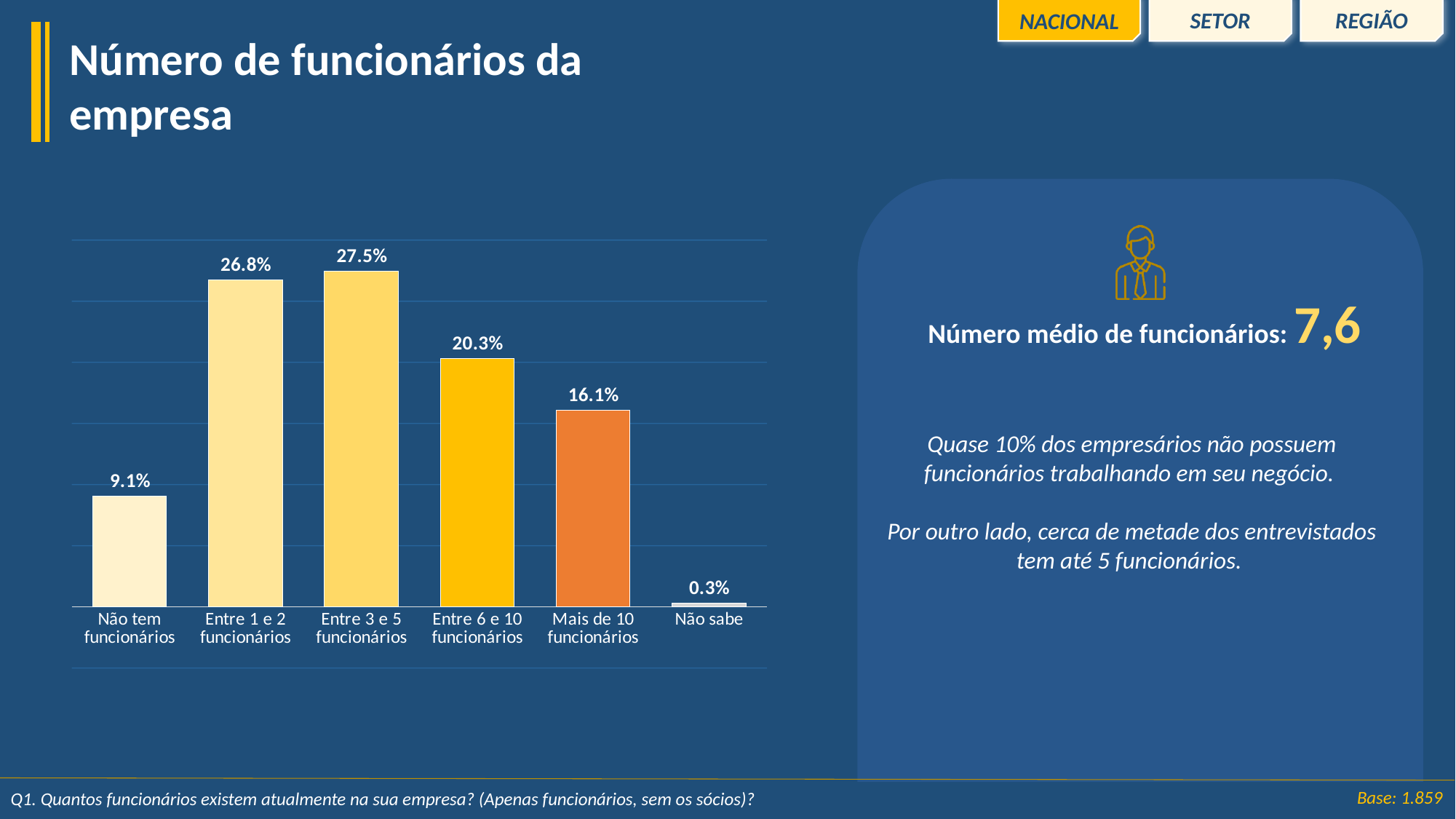
How many categories are shown in the chart? 6 What is the value for 'Entre 3 e 5 funcionários'? 27.5% Which category has the lowest value? Não sabe What is the difference between 'Entre 3 e 5 funcionários' and 'Não tem funcionários'? 18.4% What is the value for 'Não tem funcionários'? 9.1% What is the difference between 'Entre 1 e 2 funcionários' and 'Entre 6 e 10 funcionários'? 6.5% What is the title of the slide containing the chart? Número de funcionários da empresa Which is larger: 'Entre 6 e 10 funcionários' or 'Mais de 10 funcionários'? Entre 6 e 10 funcionários Which category has the highest value? Entre 3 e 5 funcionários What is the value for 'Não sabe'? 0.3% What kind of chart is shown on the slide? Bar chart What is the value for 'Mais de 10 funcionários'? 16.1%